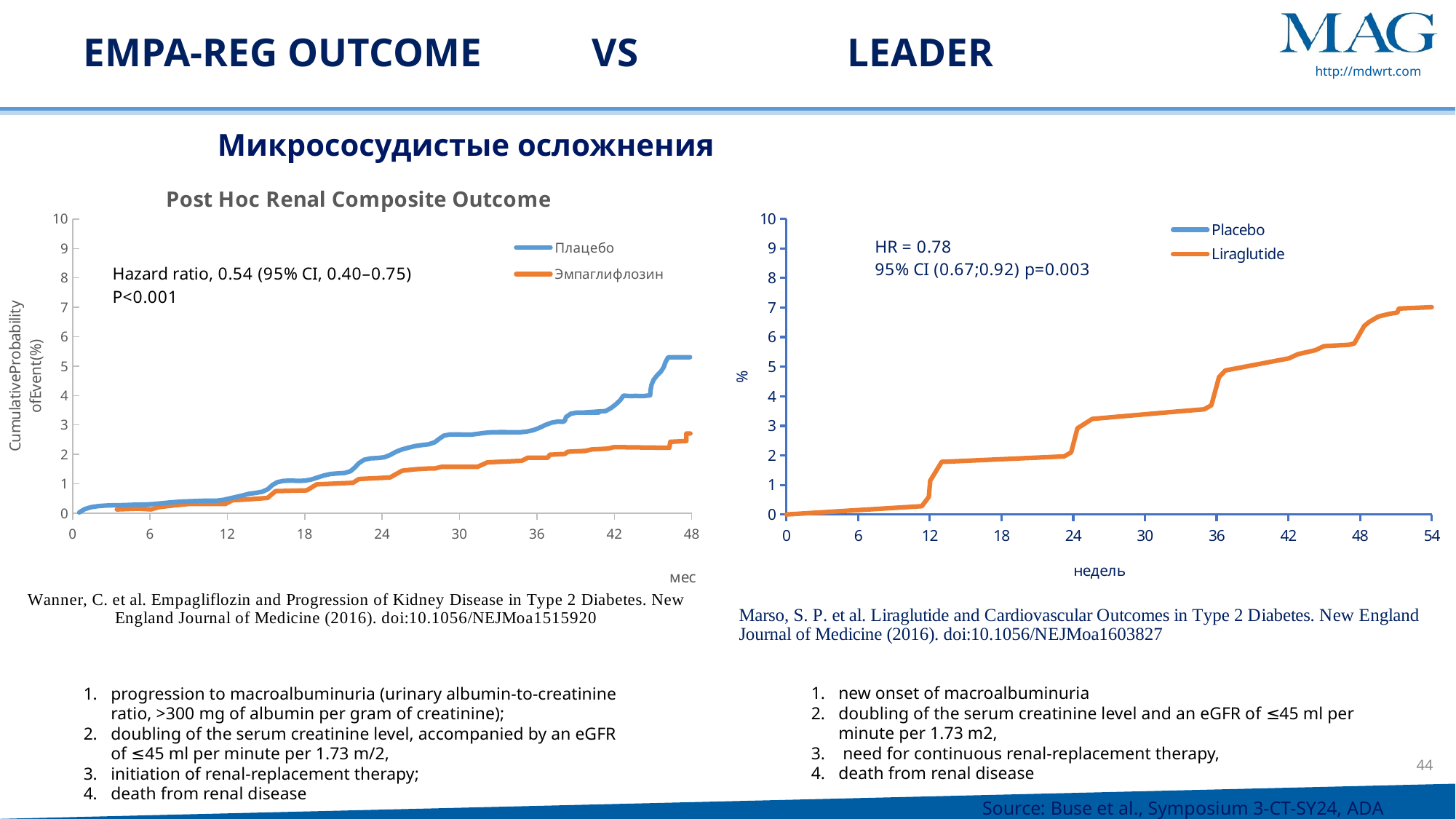
What kind of chart is the left chart titled 'Post Hoc Renal Composite Outcome'? line chart In the right chart (LEADER), is the value for Liraglutide at 30 weeks greater or less than 5? less How many series does the legend of the left chart 'Post Hoc Renal Composite Outcome' list? 2 In the left chart 'Post Hoc Renal Composite Outcome', is the value for Плацебо at 48 months greater or less than 4? greater In the left chart 'Post Hoc Renal Composite Outcome', is the value for Эмпаглифлозин at 48 months greater or less than 4? less What kind of chart is the right chart (LEADER)? line chart In the right chart (LEADER), does the Liraglutide line rise or fall as weeks increase? rise What HR value is printed on the right chart (LEADER)? 0.78 What hazard ratio is printed on the left chart 'Post Hoc Renal Composite Outcome'? 0.54 How many series does the legend of the right chart (LEADER) list? 2 In the left chart 'Post Hoc Renal Composite Outcome', which series is higher at 48 months, Плацебо or Эмпаглифлозин? Плацебо